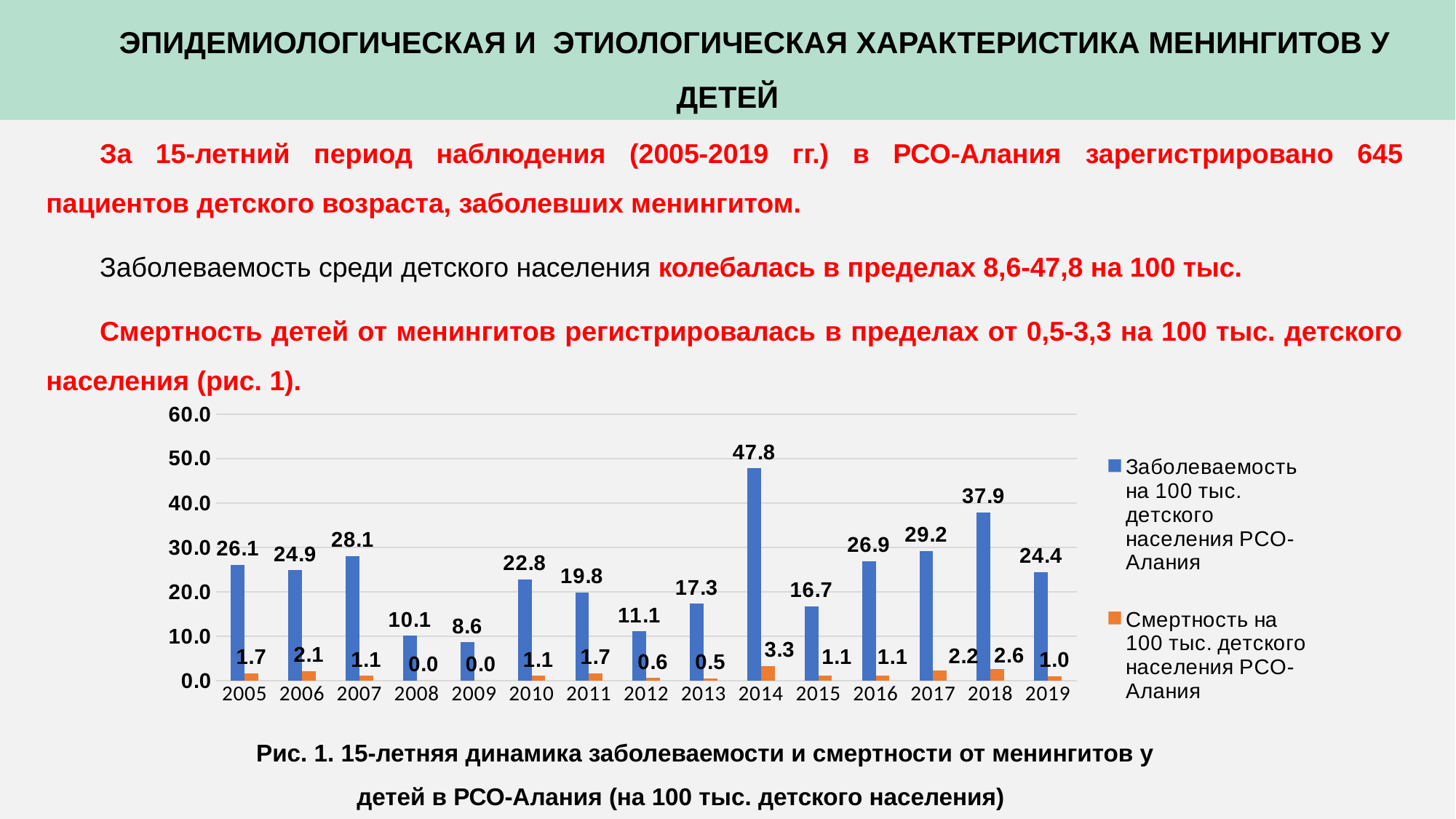
Which year has the highest mortality (Смертность) value? 2014 Which year has the highest incidence (Заболеваемость) value? 2014 How many years are shown on the x axis of the chart? 15 What type of chart is shown on the slide? Bar chart What is the difference between the incidence values for 2018 and 2019? 13.5 How many series does the chart legend list? 2 Is the incidence value for 2013 greater or less than 20.0? less What is the mortality (Смертность на 100 тыс. детского населения) value for 2018? 2.6 What colour are the bars for the mortality (Смертность) series? Orange What is the incidence (Заболеваемость на 100 тыс. детского населения) value for 2014? 47.8 Which year has a higher incidence value, 2007 or 2017? 2017 Which year has the lowest incidence (Заболеваемость) value? 2009